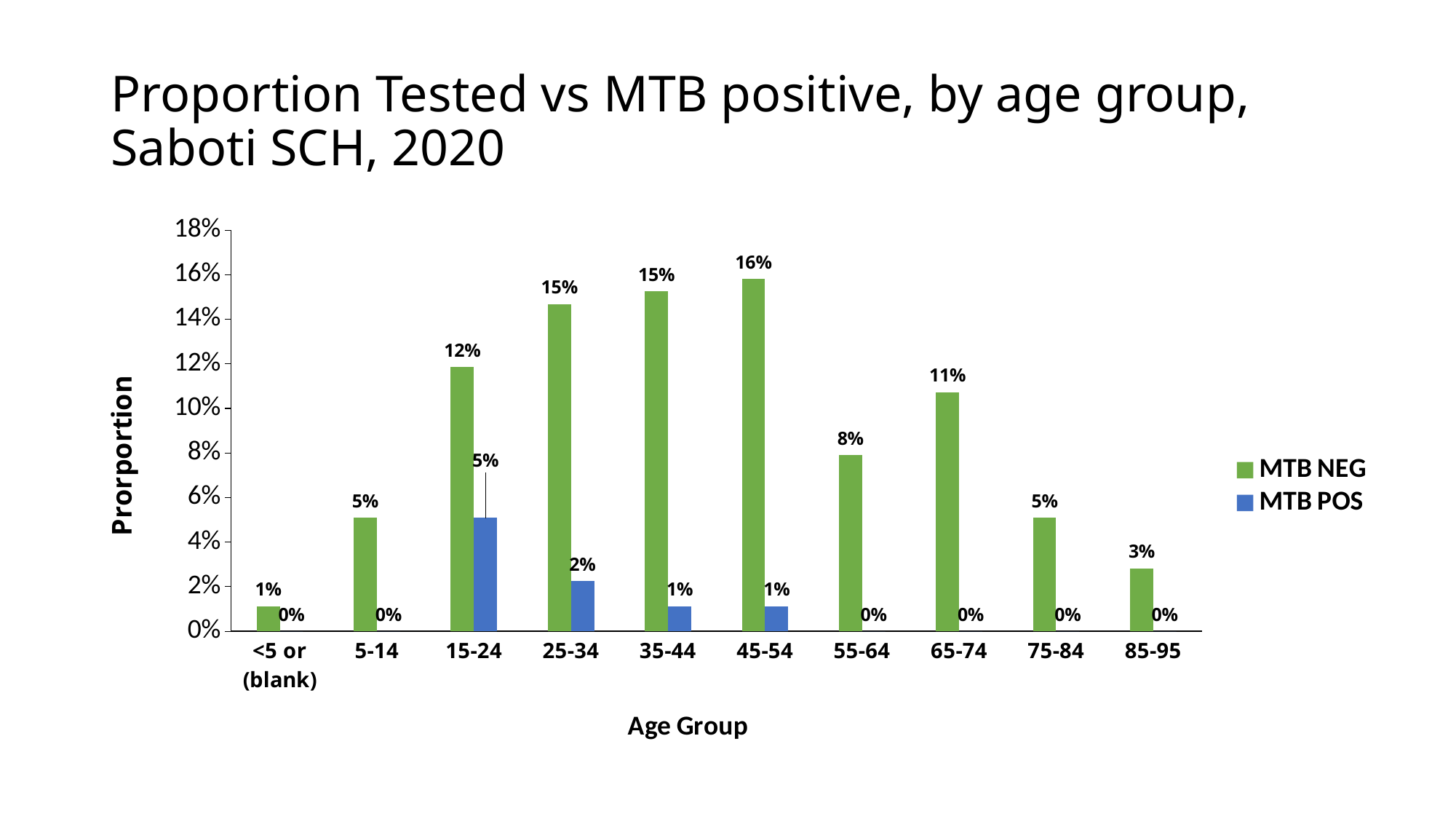
Which age group has the highest MTB POS proportion? 15-24 What is the MTB POS value for the 15-24 age group? 5% What kind of chart is shown on the slide? Bar chart What is the MTB NEG value for the 65-74 age group? 11% Which has a larger MTB NEG value, the 55-64 age group or the 65-74 age group? 65-74 What is the MTB NEG value for the 45-54 age group? 16% Which age group has the highest MTB NEG proportion? 45-54 Which age group has the lowest MTB NEG proportion? <5 or (blank) How many age groups are shown on the x axis? 10 Do the MTB POS values rise or fall from the 15-24 age group to the 55-64 age group? Fall What is the difference between the MTB NEG and MTB POS values for the 15-24 age group? 7% How many series does the legend list? 2